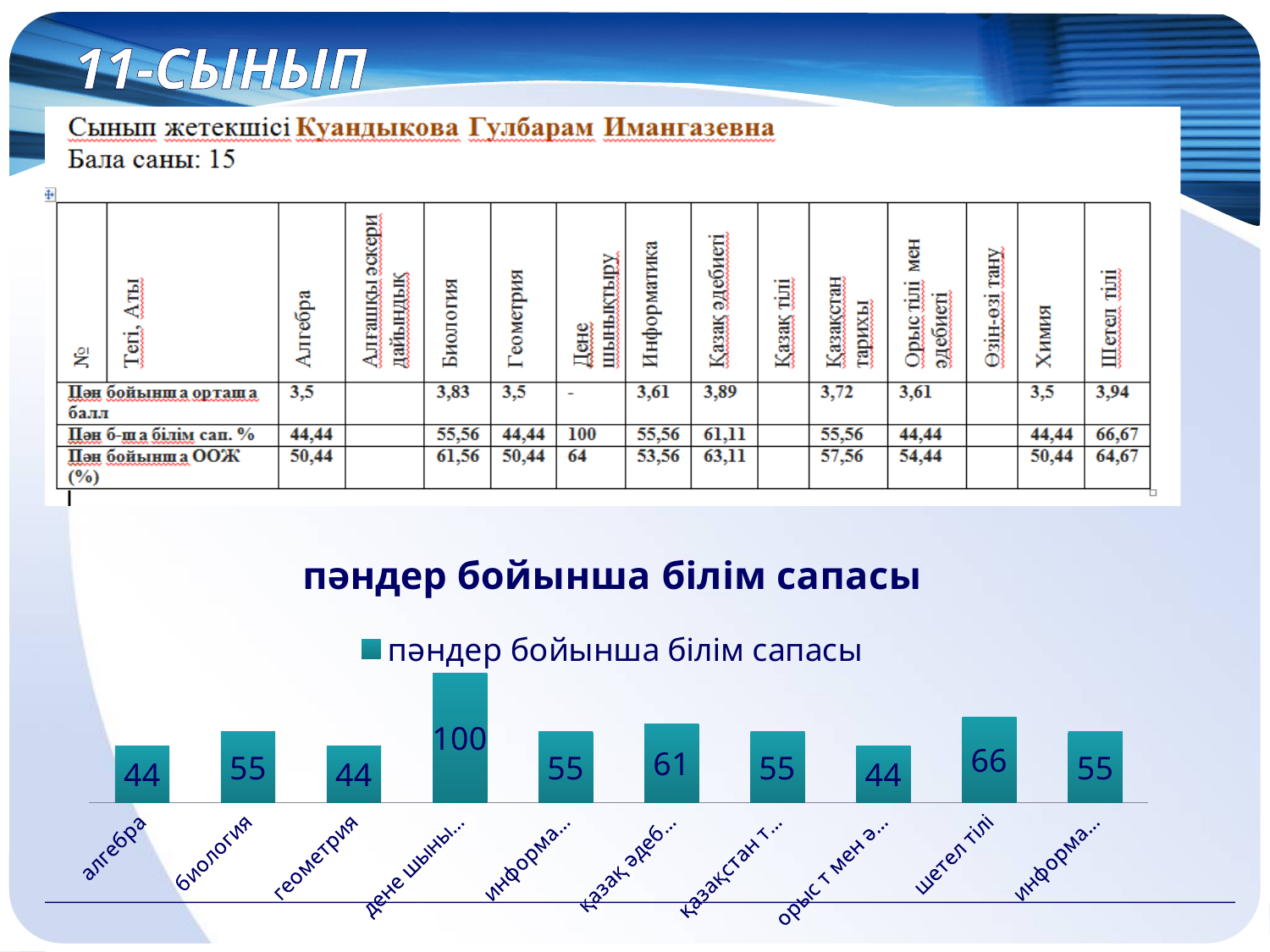
What is the difference between the highest bar (дене шыны...) and the bar for алгебра? 56 How many series does the legend of the chart list? 1 What is the value for алгебра in the chart? 44 Which is larger in the chart, the value for биология or the value for шетел тілі? шетел тілі What kind of chart is shown under the title "пәндер бойынша білім сапасы"? bar chart What is the value for шетел тілі in the chart? 66 How many bars does the chart "пәндер бойынша білім сапасы" have? 10 What is the difference between the values for шетел тілі and геометрия? 22 What is the value for the bar labelled "қазақ әдеб..." in the chart? 61 What is the value for биология in the chart? 55 Which category has the highest value in the chart? дене шыны... What is the legend entry shown above the chart? пәндер бойынша білім сапасы